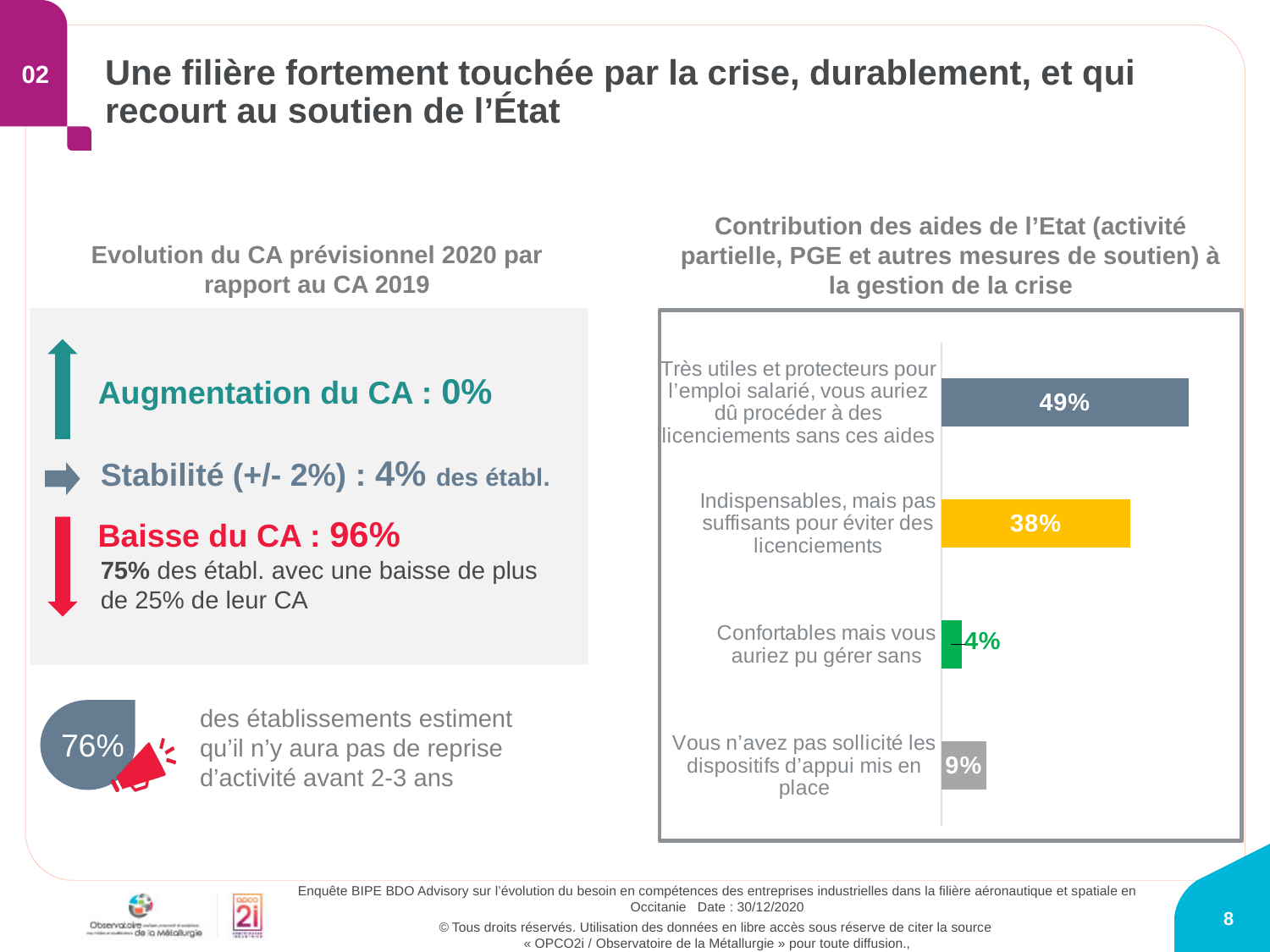
What is the title of the chart? Contribution des aides de l'Etat (activité partielle, PGE et autres mesures de soutien) à la gestion de la crise Which category has the lowest value in the chart? Confortables mais vous auriez pu gérer sans What kind of chart is shown on the slide? Bar chart Which is larger: the value for "Vous n'avez pas sollicité les dispositifs d'appui mis en place" or for "Confortables mais vous auriez pu gérer sans"? Vous n'avez pas sollicité les dispositifs d'appui mis en place What is the value for "Indispensables, mais pas suffisants pour éviter des licenciements"? 38% Which category has the highest value in the chart? Très utiles et protecteurs pour l'emploi salarié, vous auriez dû procéder à des licenciements sans ces aides What is the value for "Très utiles et protecteurs pour l'emploi salarié, vous auriez dû procéder à des licenciements sans ces aides"? 49% What is the value for "Confortables mais vous auriez pu gérer sans"? 4% What is the difference between the values for "Vous n'avez pas sollicité..." and "Confortables mais vous auriez pu gérer sans"? 5% What is the value for "Vous n'avez pas sollicité les dispositifs d'appui mis en place"? 9% How many categories are shown in the chart? 4 What is the difference between the values for "Très utiles et protecteurs..." and "Indispensables, mais pas suffisants..."? 11%